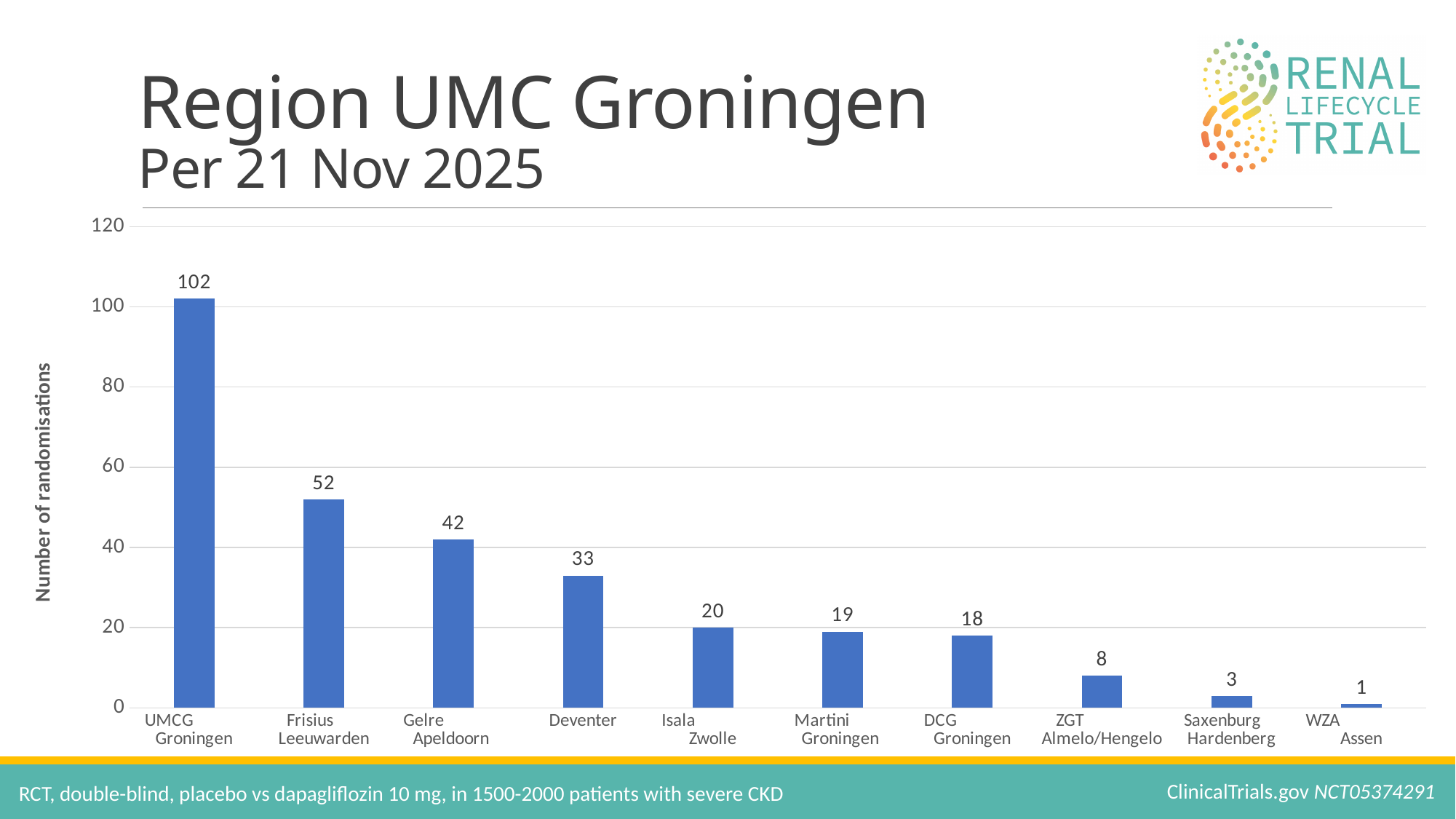
Is the value for Frisius Leeuwarden greater or less than 60? less Which has more randomisations, Gelre Apeldoorn or Deventer? Gelre Apeldoorn What is the difference in randomisations between UMCG Groningen and Frisius Leeuwarden? 50 Which site has the highest number of randomisations? UMCG Groningen How many sites are shown on the chart? 10 Which site has the lowest number of randomisations? WZA Assen What is the label of the vertical axis? Number of randomisations What is the value shown for ZGT Almelo/Hengelo? 8 What is the difference between the values for Deventer and Isala Zwolle? 13 What kind of chart is shown on the slide? bar chart What is the number of randomisations for Gelre Apeldoorn? 42 How many randomisations does UMCG Groningen have? 102